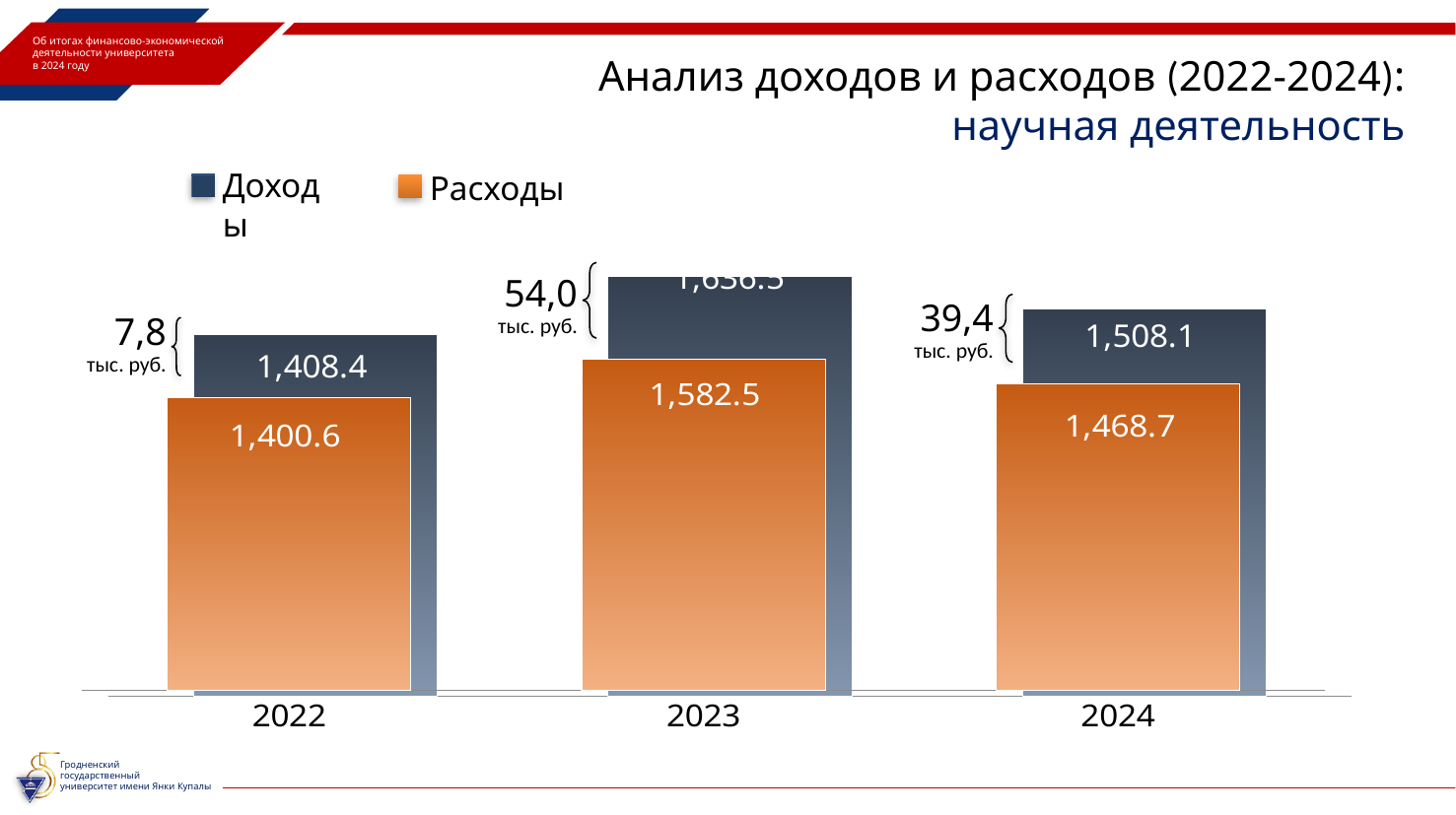
What is the value of Расходы for 2023? 1,582.5 What is the value of Расходы for 2024? 1,468.7 What kind of chart is shown on the slide? Bar chart In which year is Расходы the lowest? 2022 Which is larger in 2023, Доходы or Расходы? Доходы In which year is Расходы the highest? 2023 How many years are shown on the x axis? 3 What is the value of Доходы for 2022? 1,408.4 What is the value of Доходы for 2024? 1,508.1 How many series does the legend list? 2 What is the difference between Доходы and Расходы in 2024? 39.4 What is the value of Расходы for 2022? 1,400.6